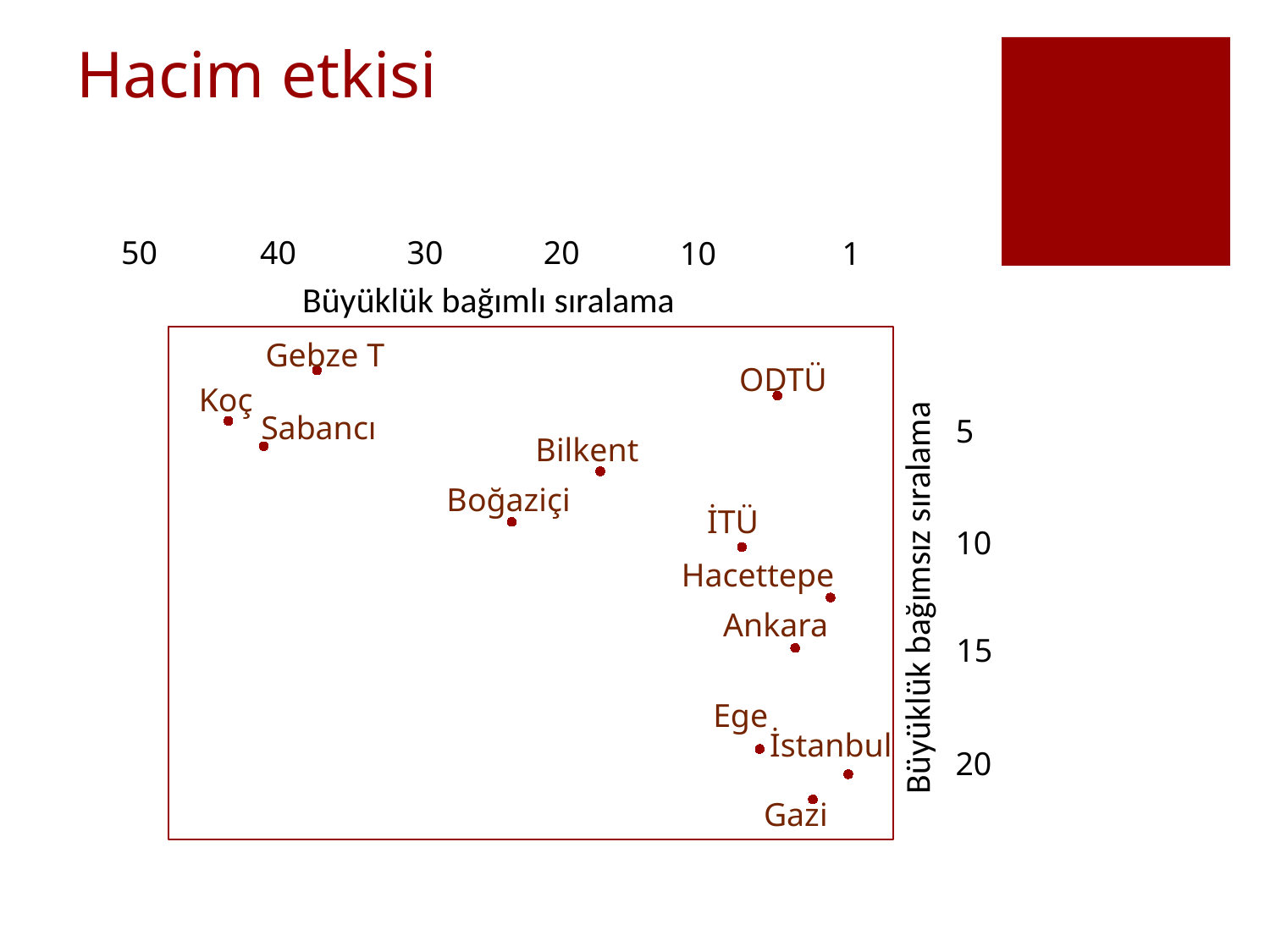
Is the Büyüklük bağımlı sıralama value for Gebze T greater or less than 40? less Which has the larger Büyüklük bağımlı sıralama value, Koç or ODTÜ? Koç What kind of chart is shown on the slide? scatter plot Which has the larger Büyüklük bağımsız sıralama value, Gazi or Gebze T? Gazi Is the Büyüklük bağımlı sıralama value for Bilkent greater or less than 20? less What is the title of the slide containing the chart? Hacim etkisi How many labelled data points are plotted in the chart? 12 Is the Büyüklük bağımsız sıralama value for ODTÜ greater or less than 5? less What is the label of the horizontal axis of the chart? Büyüklük bağımlı sıralama